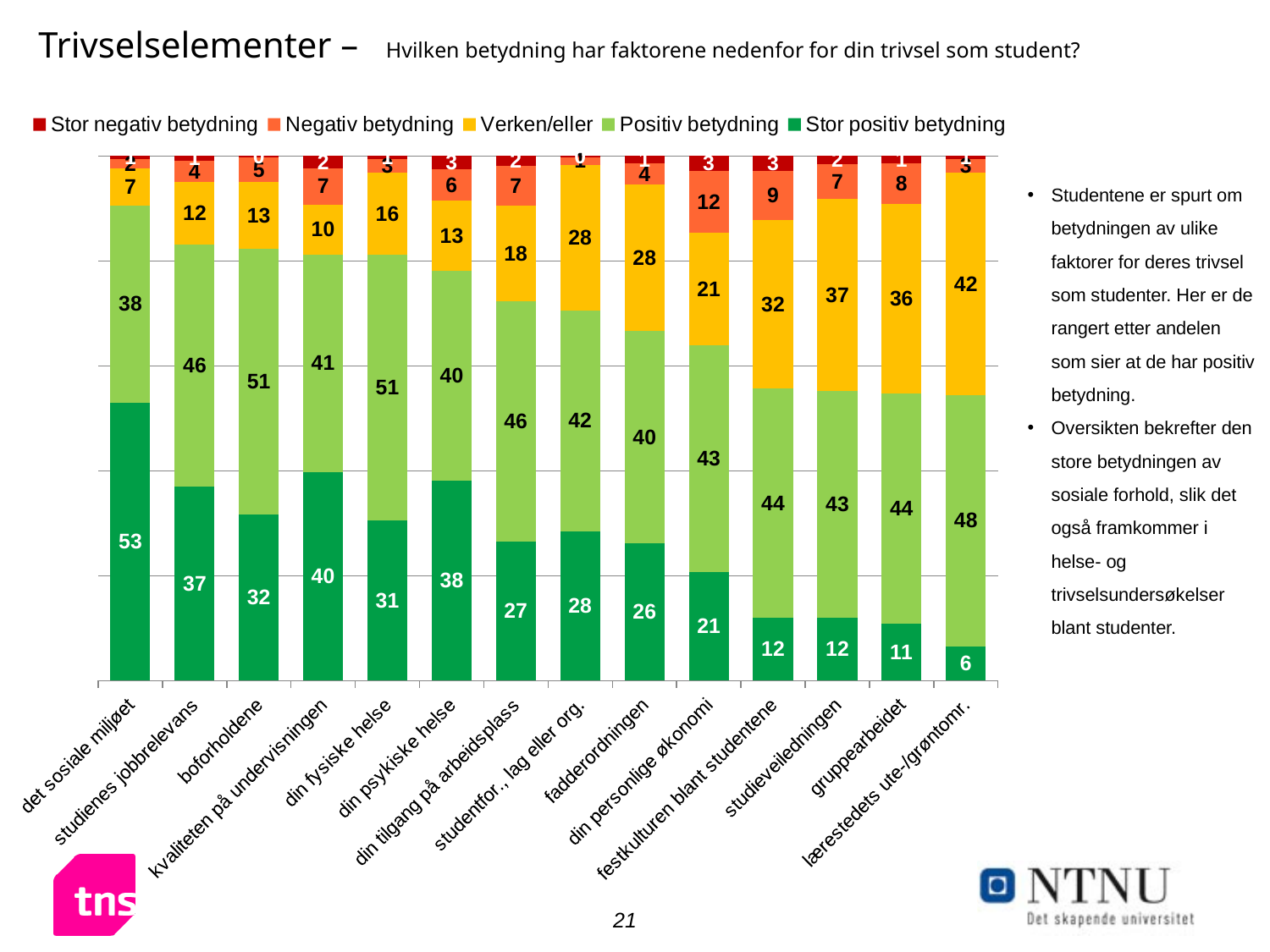
How many series does the legend list? 5 What is the difference between the 'Stor positiv betydning' values for 'det sosiale miljøet' and 'studienes jobbrelevans'? 16 What is the value of 'Positiv betydning' for 'lærestedets ute-/grøntomr.'? 48 What is the value of 'Stor positiv betydning' for 'det sosiale miljøet'? 53 Which category has the highest value for 'Stor positiv betydning'? det sosiale miljøet What kind of chart is shown on the slide? stacked bar chart What is the combined value of 'Stor positiv betydning' and 'Positiv betydning' for 'boforholdene'? 83 What is the value of 'Verken/eller' for 'studieveiledningen'? 37 What is the value of 'Negativ betydning' for 'din personlige økonomi'? 12 Which is larger: the 'Verken/eller' value for 'fadderordningen' or for 'din fysiske helse'? fadderordningen How many categories are shown along the x axis? 14 Which category has the lowest value for 'Stor positiv betydning'? lærestedets ute-/grøntomr.